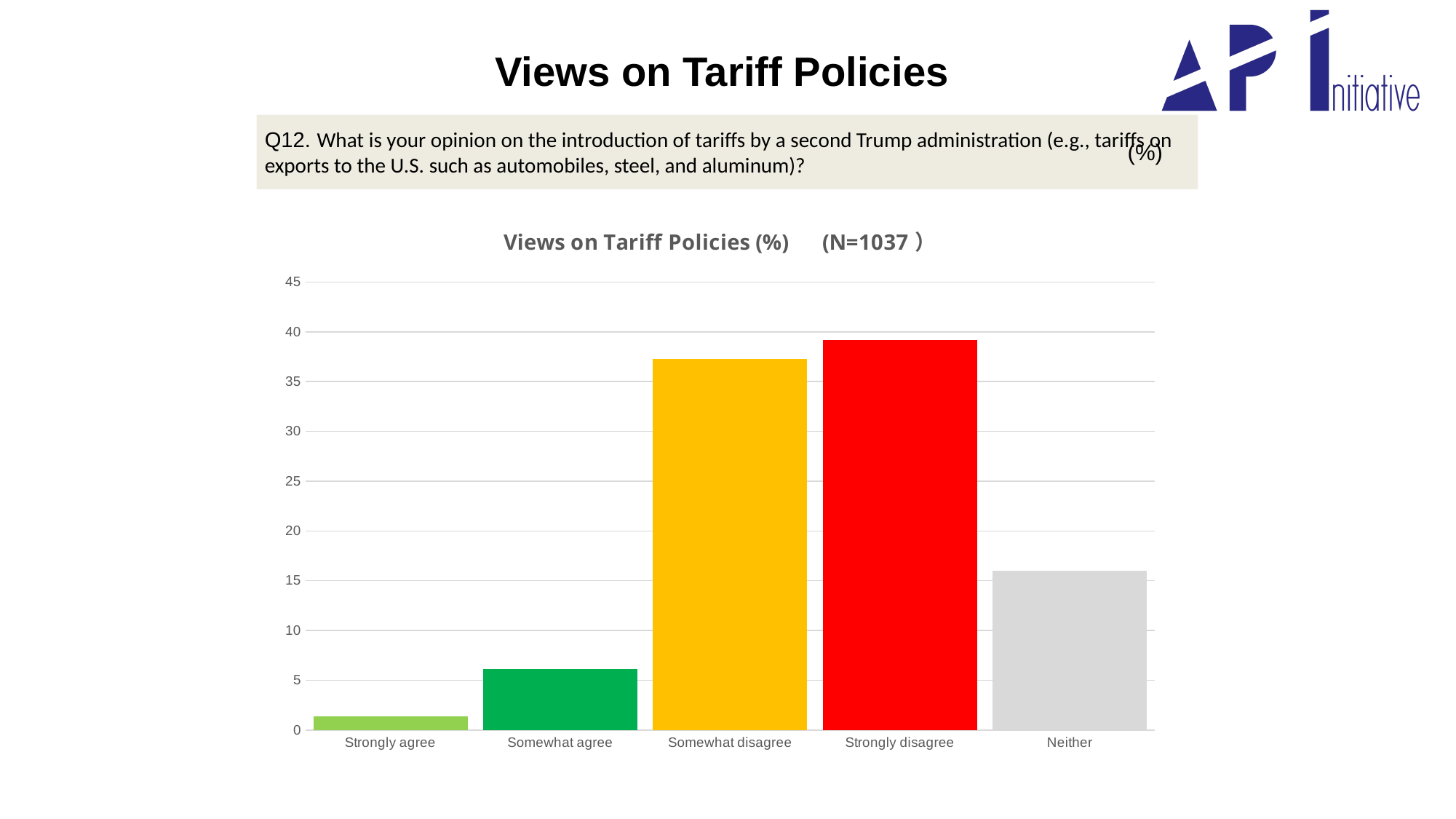
What is the sample size (N) shown in the chart title? N=1037 Which category has the lowest value in the chart? Strongly agree Is the value for Strongly disagree greater or less than 35? greater What colour is the bar for Strongly disagree? red Is the value for Somewhat agree greater or less than 10? less What kind of chart is shown on the slide? bar chart Is the value for Somewhat disagree greater or less than 35? greater Which category has the highest value in the chart? Strongly disagree Which is larger, the value for Neither or the value for Somewhat agree? Neither How many categories are shown on the x axis of the chart? 5